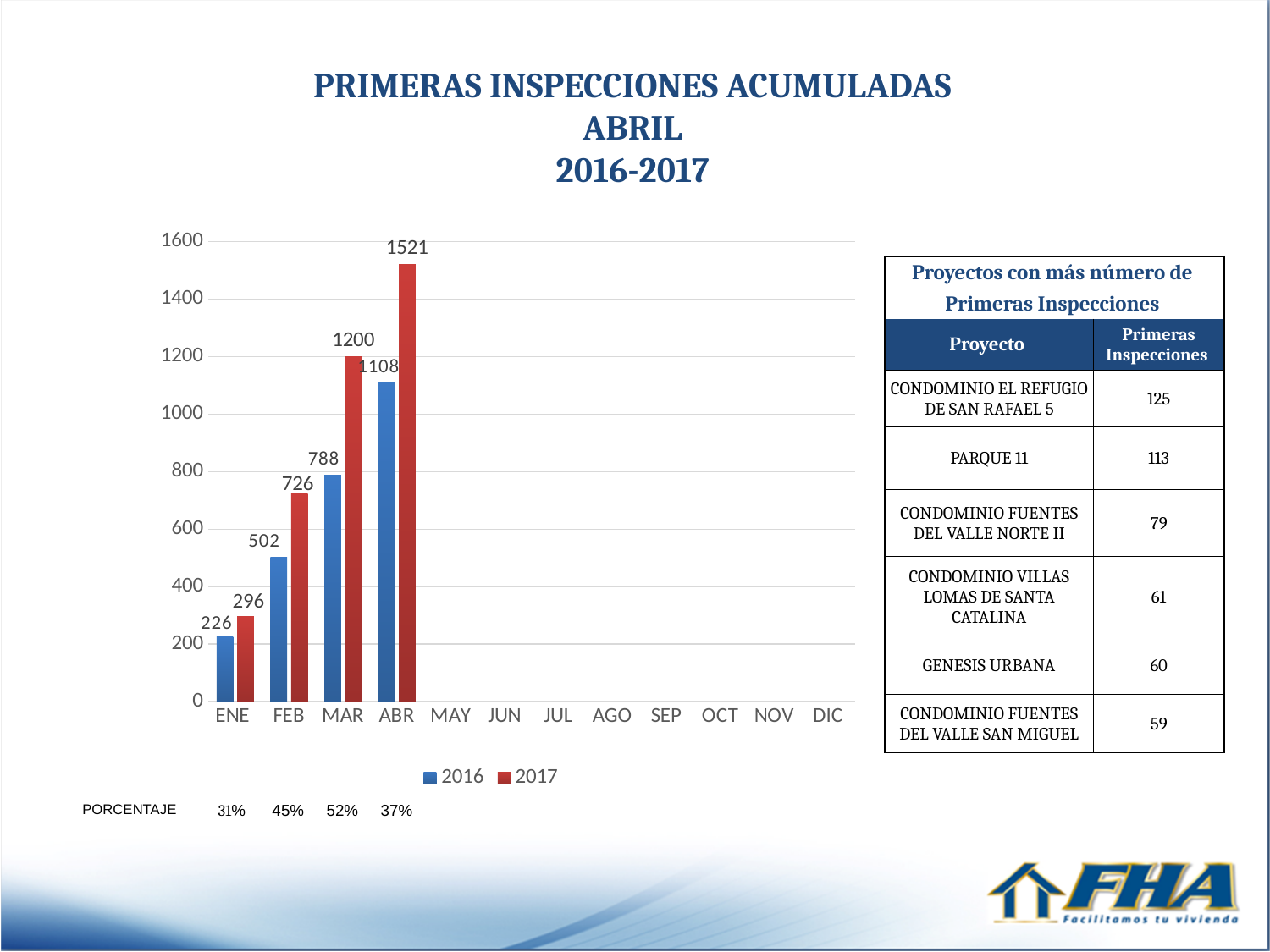
What is the value for 2016 in FEB? 502 What is the value for 2017 in MAR? 1200 What is the value for 2017 in ABR? 1521 What colour are the bars for the 2017 series? red Which month has the highest value for the 2016 series? ABR Which month has the lowest value for the 2017 series? ENE Do the 2017 values rise or fall from ENE to ABR? rise What type of chart is shown on the slide? bar chart What is the difference between the 2017 and 2016 values in MAR? 412 How many series does the chart legend list? 2 Which is larger in ENE, the 2016 value or the 2017 value? 2017 How many month categories are shown on the x axis? 12